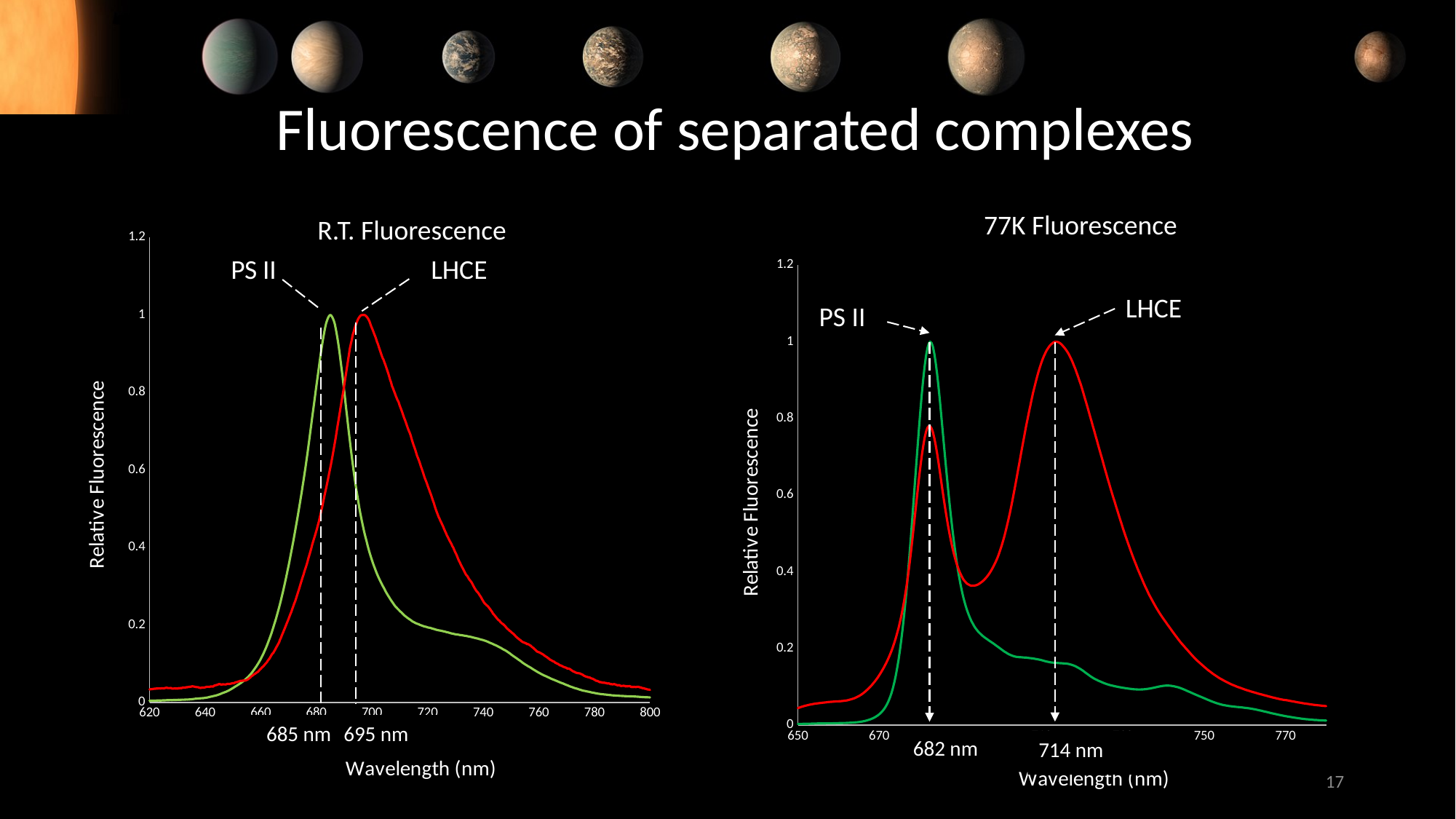
What is the label on the y axis of the R.T. Fluorescence chart? Relative Fluorescence In the 77K Fluorescence chart, is the relative fluorescence of the LHCE curve at 682 nm greater or less than 0.6? greater In the R.T. Fluorescence chart, what is the difference between the annotated LHCE peak wavelength and the PS II peak wavelength? 10 nm In the 77K Fluorescence chart, is the relative fluorescence of the PS II curve at 714 nm greater or less than 0.4? less How many curves are plotted in the 77K Fluorescence chart? 2 In the R.T. Fluorescence chart, which curve has the higher relative fluorescence at 740 nm, PS II or LHCE? LHCE What kind of chart is the R.T. Fluorescence chart on the left? line chart In the R.T. Fluorescence chart, at what wavelength does the LHCE curve peak, as annotated on the slide? 695 nm In the R.T. Fluorescence chart, at what wavelength does the PS II curve peak, as annotated on the slide? 685 nm In the 77K Fluorescence chart, at what wavelength does the LHCE peak occur, as annotated on the slide? 714 nm In the 77K Fluorescence chart, at what wavelength does the PS II peak occur, as annotated on the slide? 682 nm In the 77K Fluorescence chart, what is the difference between the annotated LHCE peak wavelength and the PS II peak wavelength? 32 nm